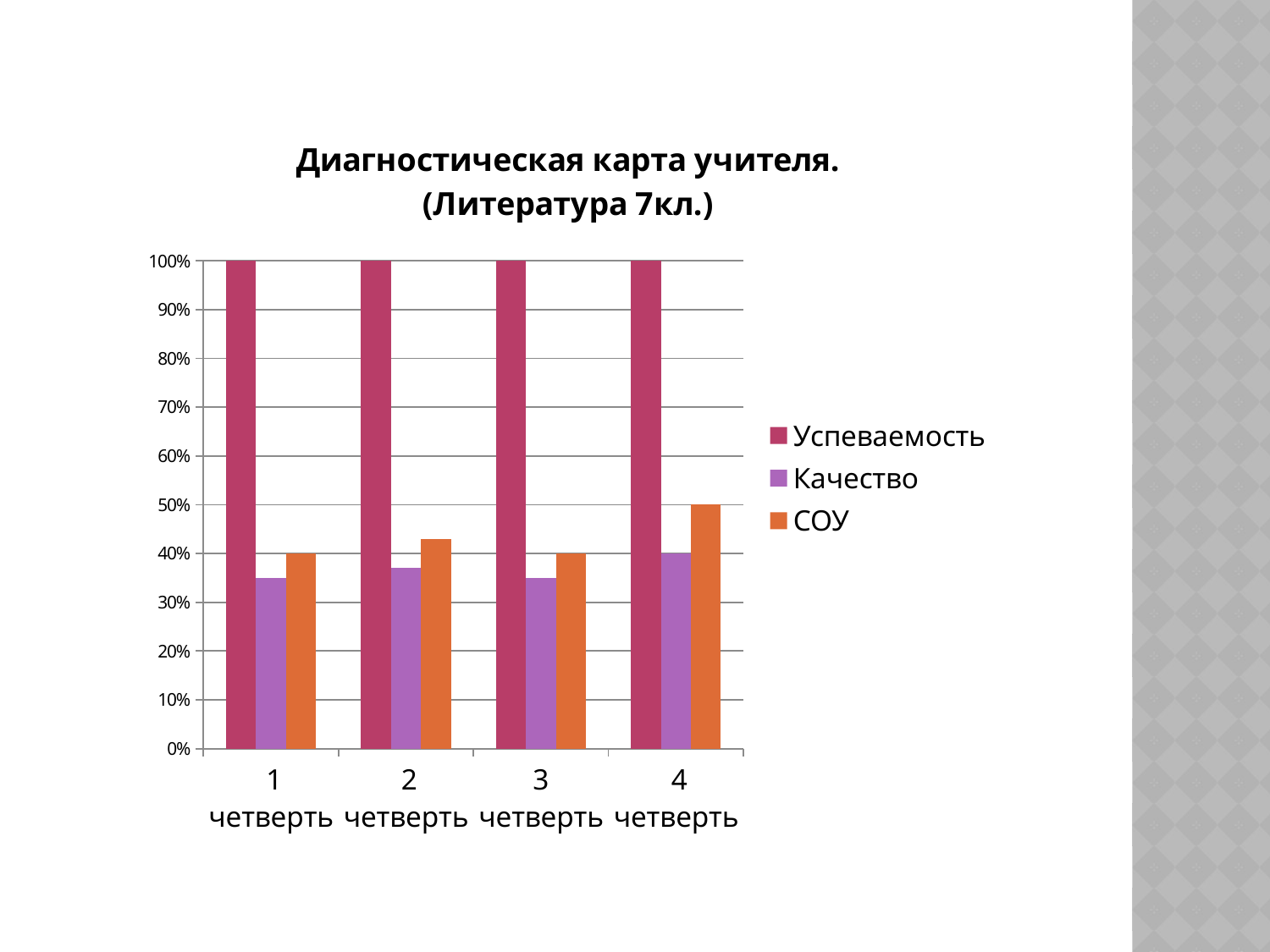
Does the Успеваемость series rise, fall or stay the same across the quarters? stays the same What is the title of the chart? Диагностическая карта учителя. (Литература 7кл.) What is the value of Успеваемость for 1 четверть? 100% In which quarter is the СОУ value highest? 4 четверть What is the value of СОУ for 4 четверть? 50% In 3 четверть, which is larger: Качество or СОУ? СОУ How many categories are shown on the x axis? 4 What kind of chart is shown on the slide? bar chart How many series does the legend list? 3 Is the value of Качество for 1 четверть greater or less than 40%? less What is the value of СОУ for 1 четверть? 40% Is the value of СОУ for 2 четверть greater or less than 40%? greater